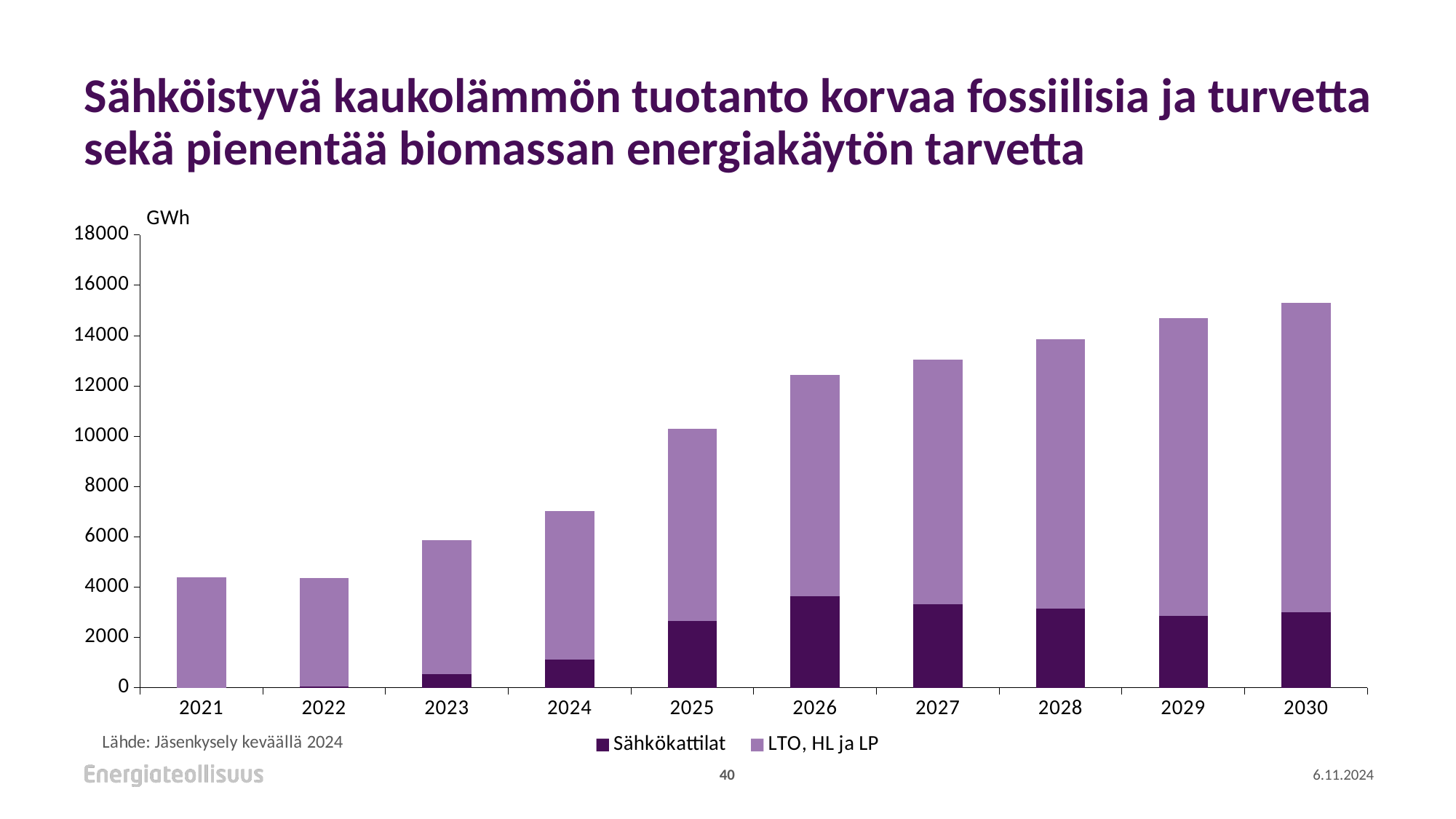
How many years are shown on the x axis of the chart? 10 Which is larger, the total bar for 2025 or the total bar for 2024? 2025 Which year has the highest total bar in the chart? 2030 What unit is shown on the y axis of the chart? GWh Is the total bar for 2030 greater or less than 14000 GWh? greater Which year has the highest value for Sähkökattilat? 2026 Is the total bar for 2024 greater or less than 8000 GWh? less Is the value for Sähkökattilat in 2026 greater or less than 4000 GWh? less How many series does the chart legend list? 2 What kind of chart is shown on the slide? Stacked bar chart Do the total bars generally rise or fall from 2021 to 2030? rise